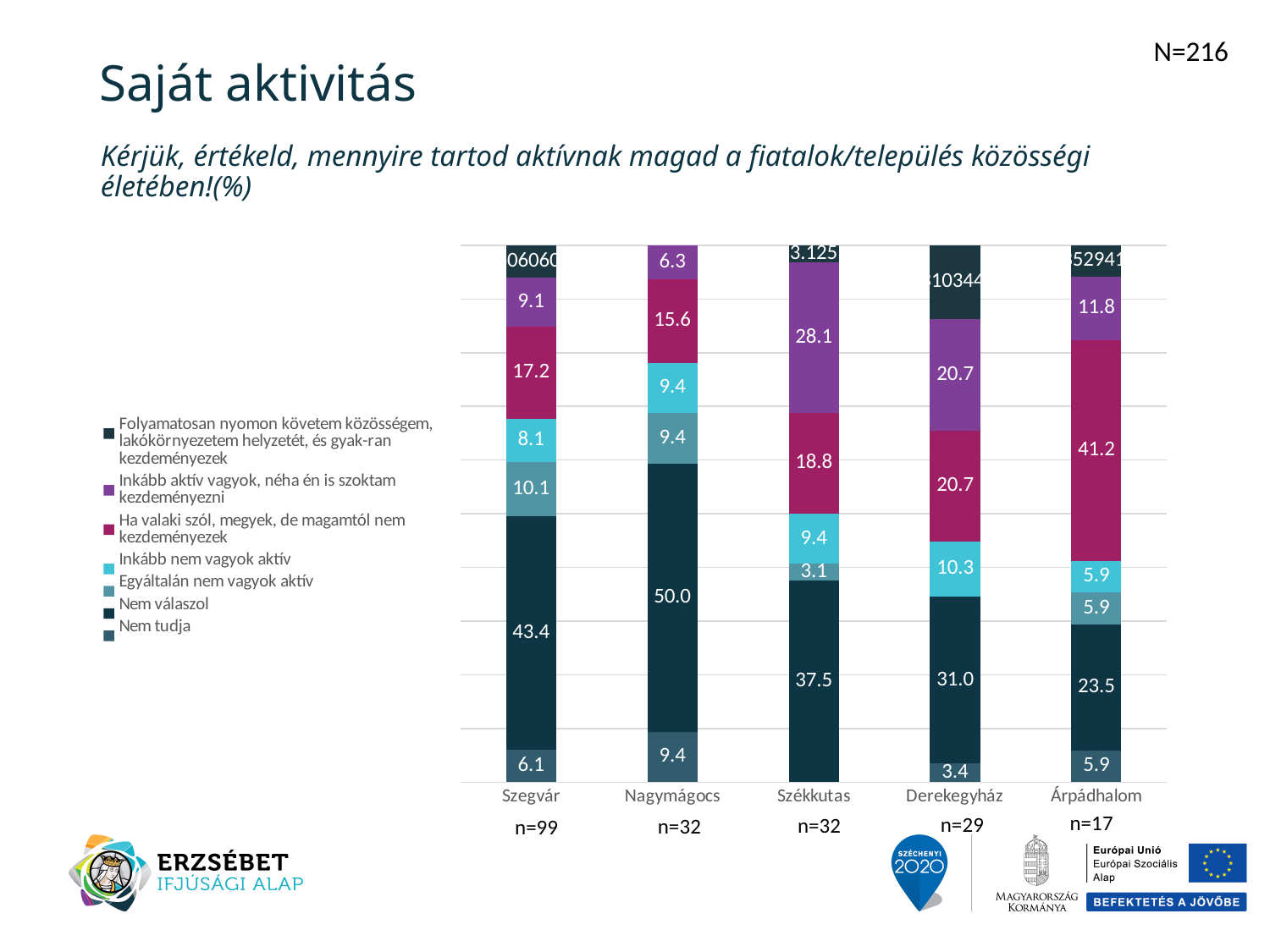
What kind of chart is shown on the slide? stacked bar chart Which is larger: the magenta segment (Ha valaki szól) for Szegvár or for Nagymágocs? Szegvár What is the value of the light blue segment (Inkább nem vagyok aktív) for Derekegyház? 10.3 What is the difference between the purple segment (Inkább aktív vagyok) for Székkutas and for Nagymágocs? 21.8 What is the value of the purple segment (Inkább aktív vagyok, néha én is szoktam kezdeményezni) for Székkutas? 28.1 What is the value of the largest segment in the Nagymágocs bar? 50.0 Which settlement has the smallest purple segment (Inkább aktív vagyok, néha én is szoktam kezdeményezni)? Nagymágocs How many series does the chart's legend list? 7 Which settlement has the largest magenta segment (Ha valaki szól, megyek, de magamtól nem kezdeményezek)? Árpádhalom What sample size (n) is shown under the Szegvár bar? n=99 What is the value of the magenta segment (Ha valaki szól, megyek, de magamtól nem kezdeményezek) for Árpádhalom? 41.2 How many settlements (categories) are shown on the x axis of the chart? 5